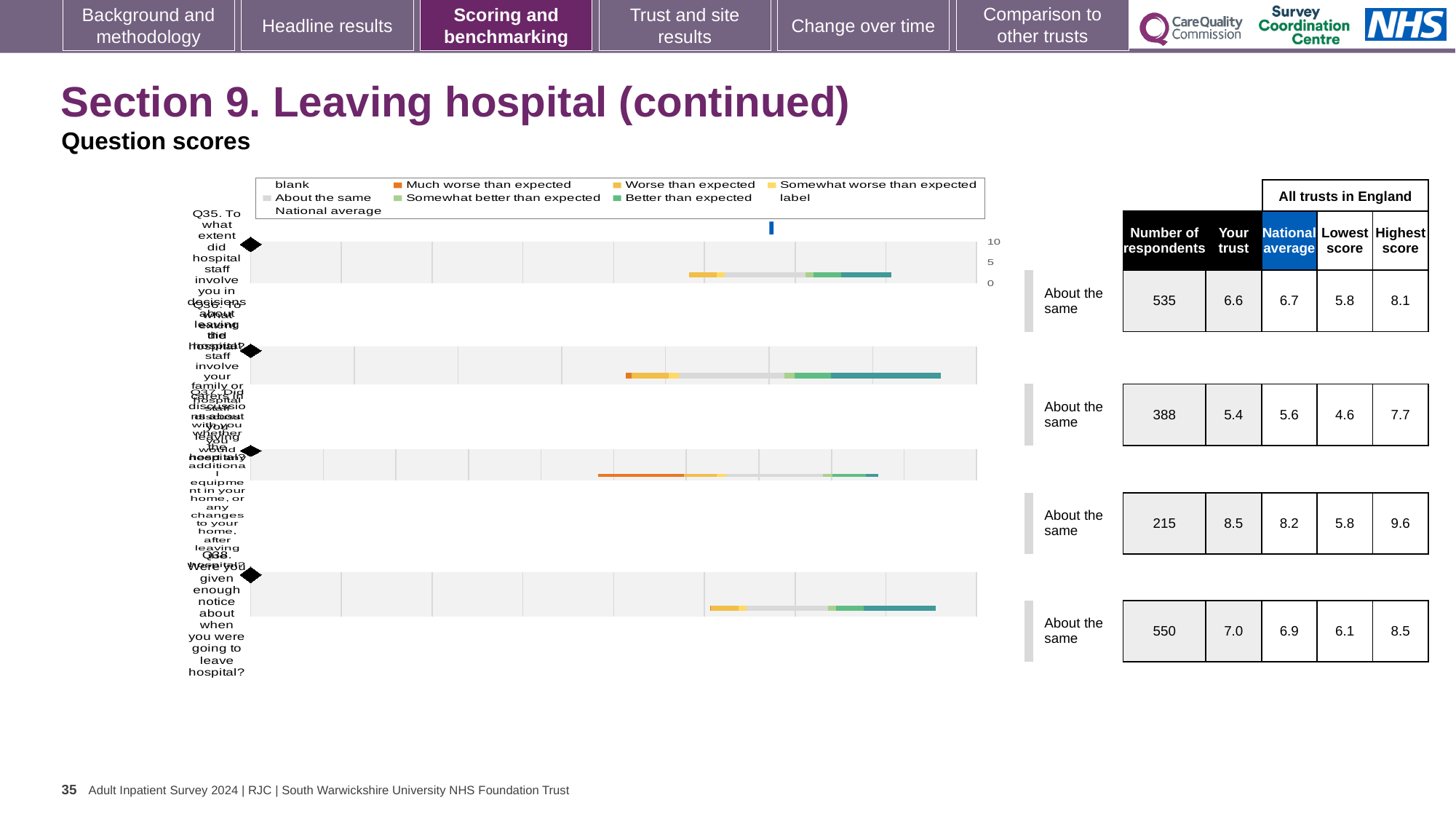
Which chart (by position from the top) has the highest 'Your trust' score? Third chart from the top (8.5) For the top chart (Q35), which is larger: the 'Your trust' score or the national average? National average For the bottom chart (Q38), what is the highest score among all trusts in England? 8.5 How many question charts (rows) are shown on the slide? 4 What benchmark category is shown next to the top chart (Q35)? About the same For the bottom chart (Q38), what is the national average score? 6.9 For the top chart (Q35), what is the 'Your trust' score? 6.6 For the top chart (Q35), what is the number of respondents? 535 For the second chart from the top, what is the lowest score among all trusts in England? 4.6 For the bottom chart (Q38), what is the difference between the highest score and the lowest score? 2.4 What kind of chart is used to show the question scores on this slide? bar chart Which chart (by position from the top) has the lowest 'Your trust' score? Second chart from the top (5.4)